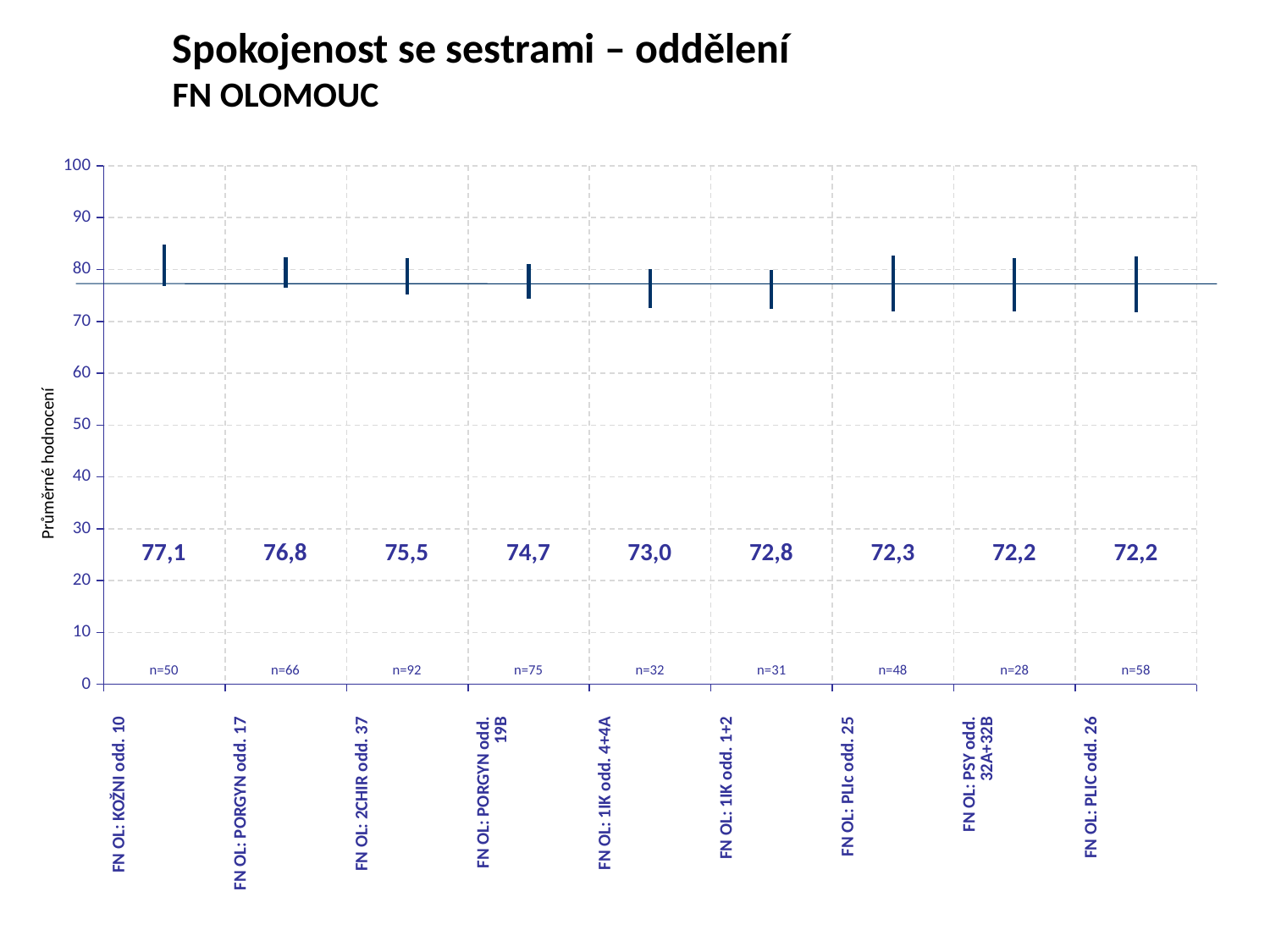
What is the difference between the average ratings of FN OL: PORGYN odd. 17 and FN OL: 2CHIR odd. 37? 1,3 How many departments are shown on the chart? 9 Which has a higher average rating, FN OL: 1IK odd. 4+4A or FN OL: 1IK odd. 1+2? FN OL: 1IK odd. 4+4A What is the label of the vertical axis? Průměrné hodnocení What is the average rating for FN OL: KOŽNÍ odd. 10? 77,1 Which department has the highest average rating? FN OL: KOŽNÍ odd. 10 What is the average rating for FN OL: PLIc odd. 25? 72,3 What is the difference between the average ratings of FN OL: KOŽNÍ odd. 10 and FN OL: PLIC odd. 26? 4,9 Do the average ratings rise or fall from left to right across the chart? fall What is the sample size (n) shown for FN OL: 2CHIR odd. 37? n=92 What is the sample size (n) shown for FN OL: PSY odd. 32A+32B? n=28 What is the average rating for FN OL: PORGYN odd. 19B? 74,7